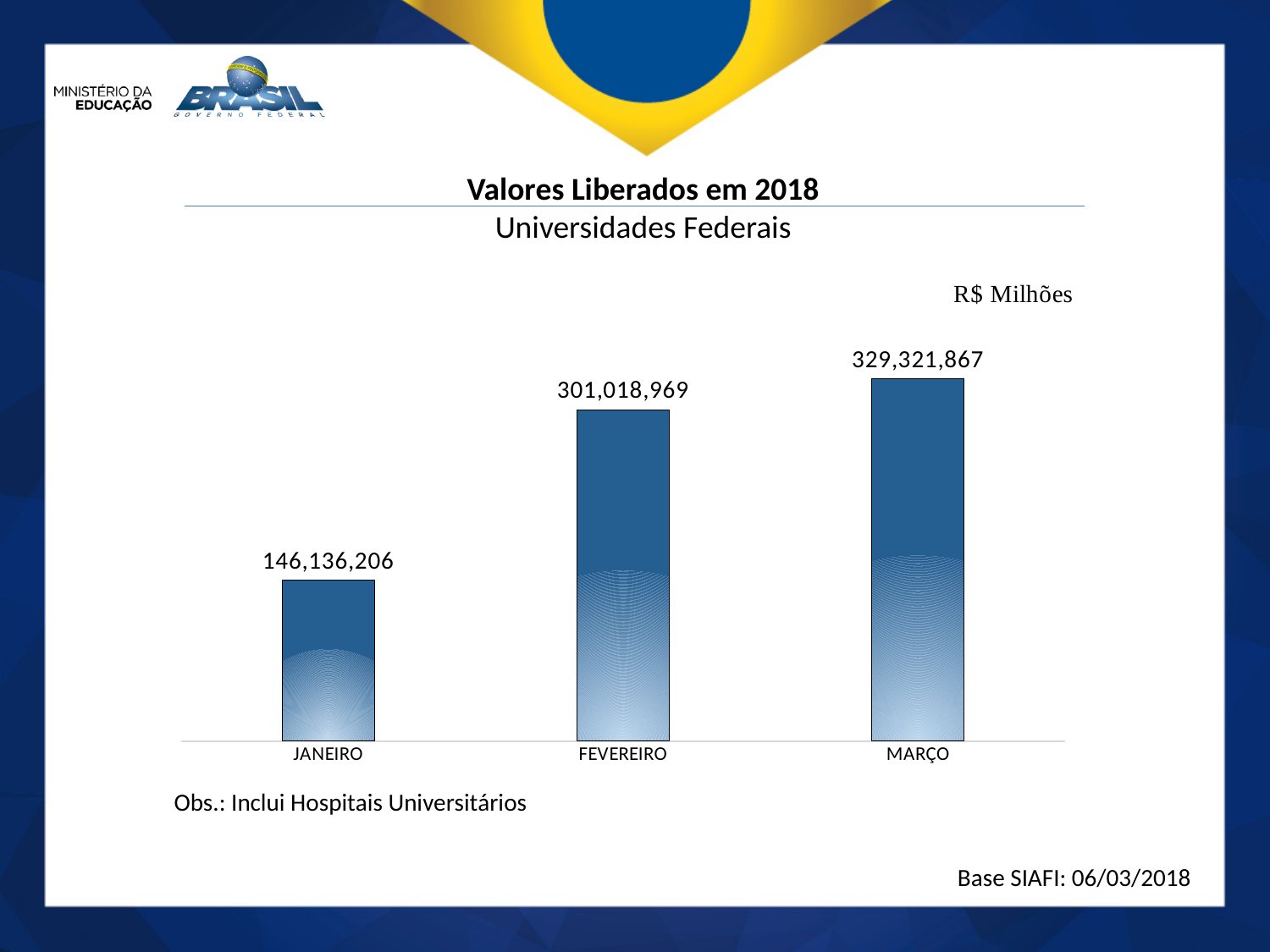
What is the difference between the values for MARÇO and FEVEREIRO? 28,302,898 What kind of chart is shown on the slide? Bar chart What unit is indicated for the values on the chart? R$ Milhões What value is shown for MARÇO? 329,321,867 What value is shown for FEVEREIRO? 301,018,969 Do the values rise or fall from JANEIRO to MARÇO? Rise How many months are shown on the chart? 3 Which month has the highest value? MARÇO What is the difference between the values for FEVEREIRO and JANEIRO? 154,882,763 Which month has the lowest value? JANEIRO Which is larger, the value for FEVEREIRO or the value for JANEIRO? FEVEREIRO What value is shown for JANEIRO? 146,136,206